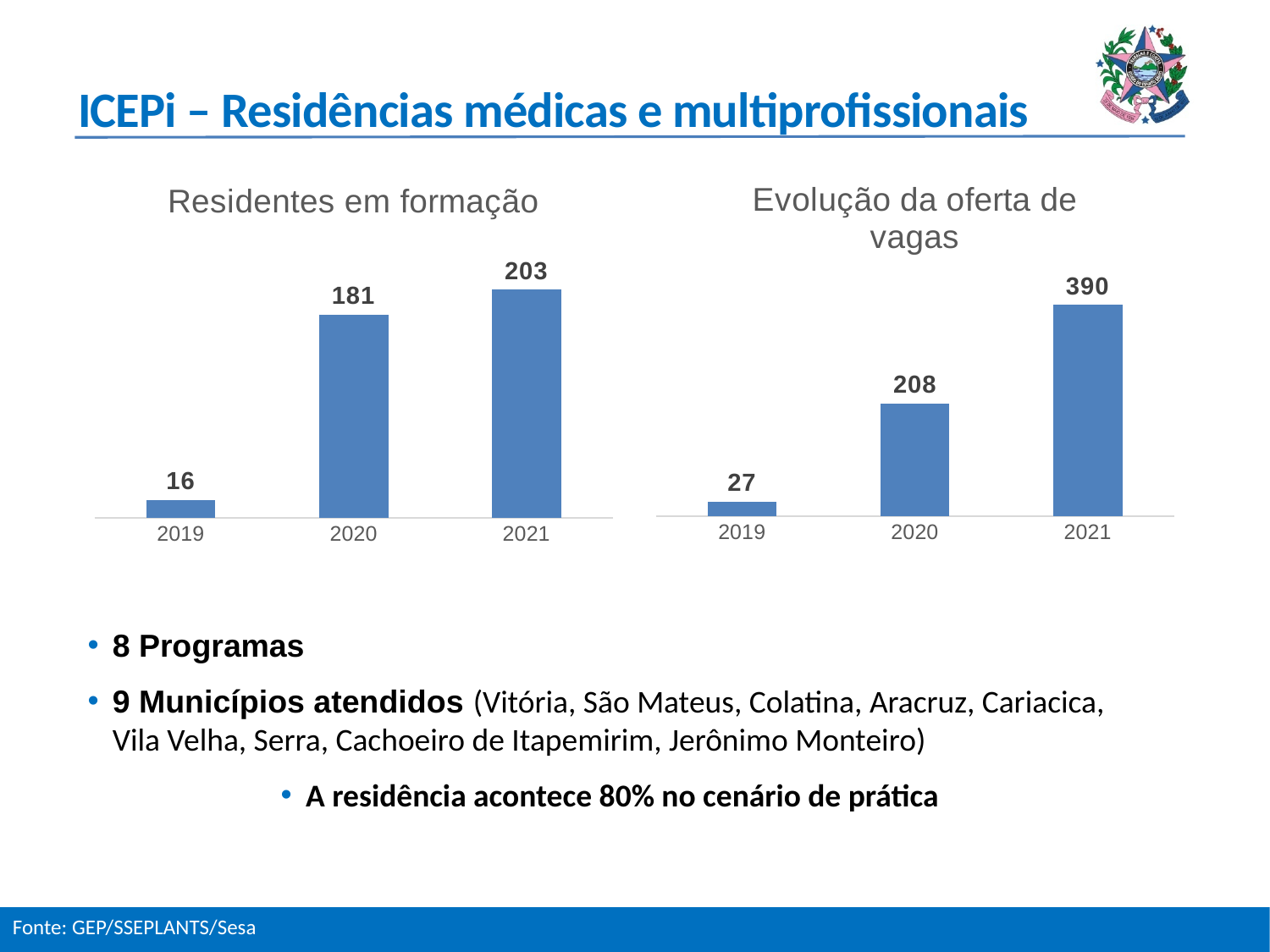
In the 'Evolução da oferta de vagas' chart, what is the value for 2019? 27 In the 'Residentes em formação' chart, do the values rise or fall from 2019 to 2021? rise In the 'Evolução da oferta de vagas' chart, which year has the lowest value? 2019 In the 'Residentes em formação' chart, which year has the highest value? 2021 What is the title of the chart on the left side of the slide? Residentes em formação In the 'Evolução da oferta de vagas' chart, what is the difference between the values for 2021 and 2020? 182 In the 'Residentes em formação' chart, what is the value for 2019? 16 In the 'Evolução da oferta de vagas' chart, which is larger, the value for 2020 or the value for 2021? 2021 How many years are shown in the 'Residentes em formação' chart? 3 What kind of chart is the 'Evolução da oferta de vagas' chart? bar chart In the 'Residentes em formação' chart, what is the value for 2020? 181 In the 'Residentes em formação' chart, what is the difference between the values for 2021 and 2020? 22